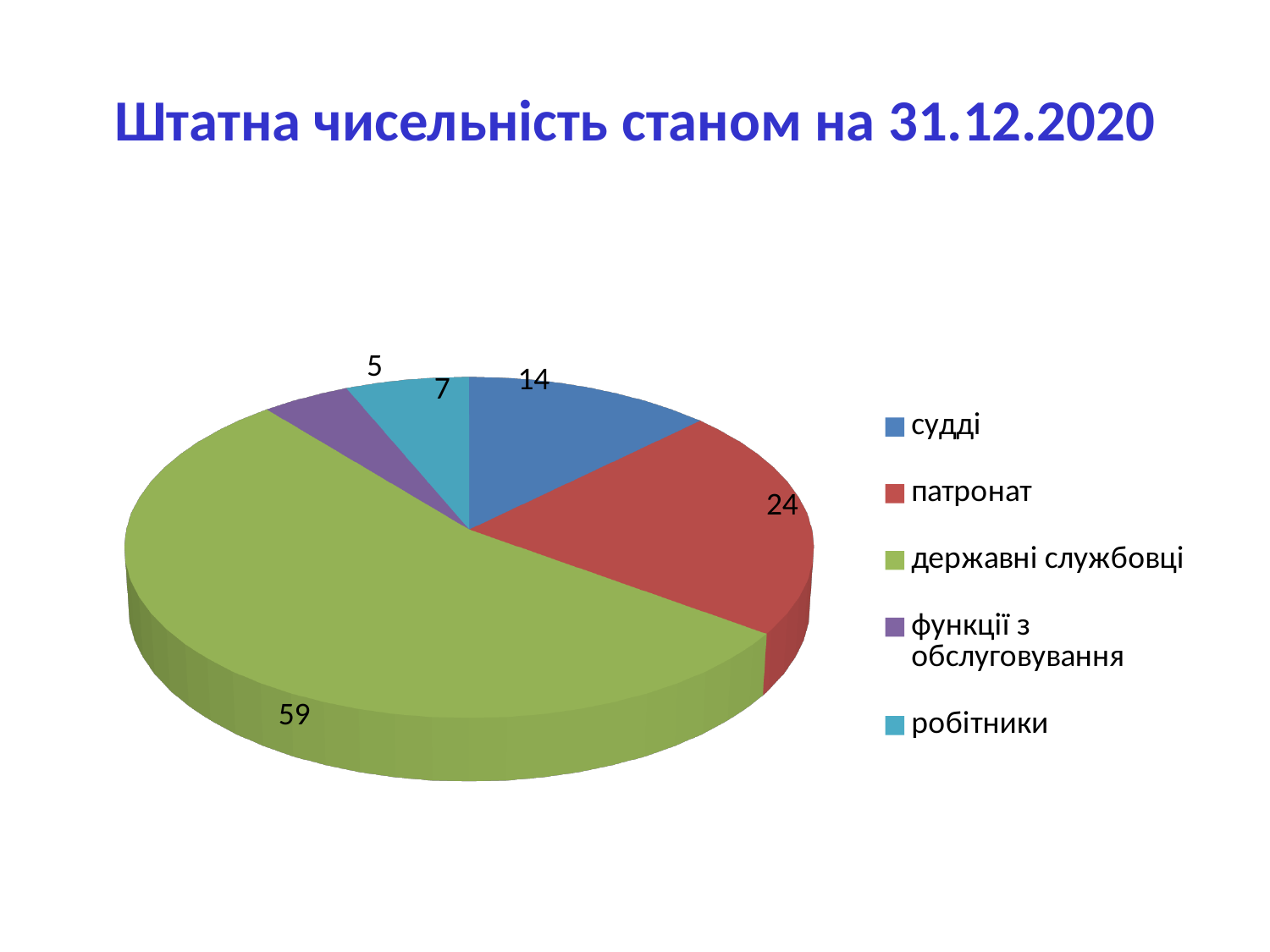
What is the value for робітники? 7 What is the value for патронат? 24 What is the value for функції з обслуговування? 5 What kind of chart is shown on the slide? pie chart What is the value for судді? 14 What is the value for державні службовці? 59 How many categories does the legend list? 5 What is the title of the chart? Штатна чисельність станом на 31.12.2020 What is the difference between the values for патронат and судді? 10 Which is larger, the value for робітники or the value for функції з обслуговування? робітники Which category has the smallest slice? функції з обслуговування Which category has the largest slice? державні службовці